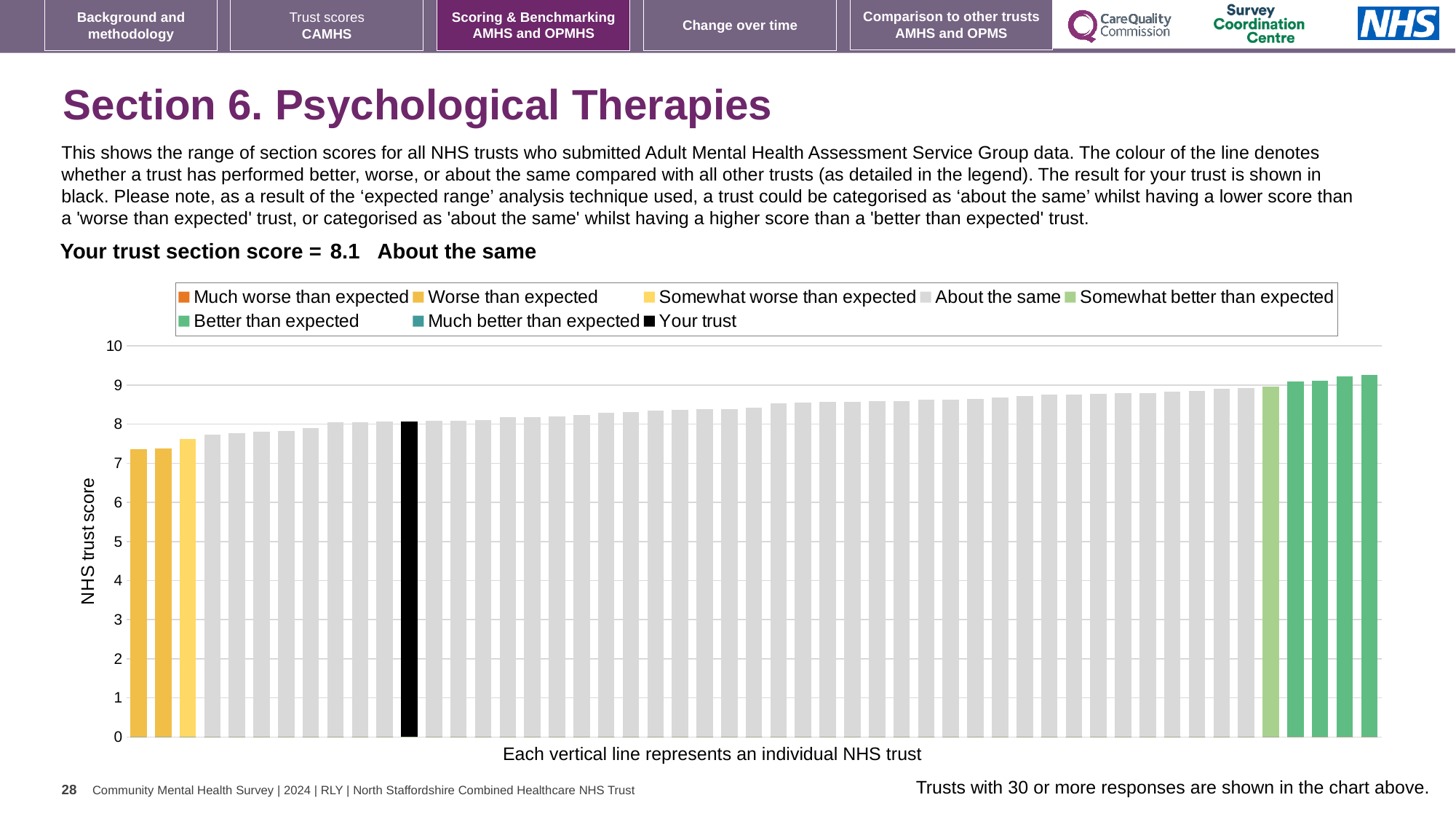
What is the label on the vertical axis of the chart? NHS trust score Is the value of the lowest bar in the chart greater or less than 8? less How many bars are coloured as 'Better than expected' (green) in the chart? 4 What is the section score for your trust shown on the slide? 8.1 Is the value of the black 'Your trust' bar greater or less than 9? less Is the leftmost bar in the chart higher or lower than the rightmost bar? lower What kind of chart is shown on the slide? bar chart Which performance category is your trust placed in according to the slide? About the same Do the bar values rise or fall from left to right across the chart? rise How many bars are coloured as 'Worse than expected' (dark yellow) in the chart? 2 How many entries does the chart legend list? 8 Is the value of the highest bar in the chart greater or less than 9? greater